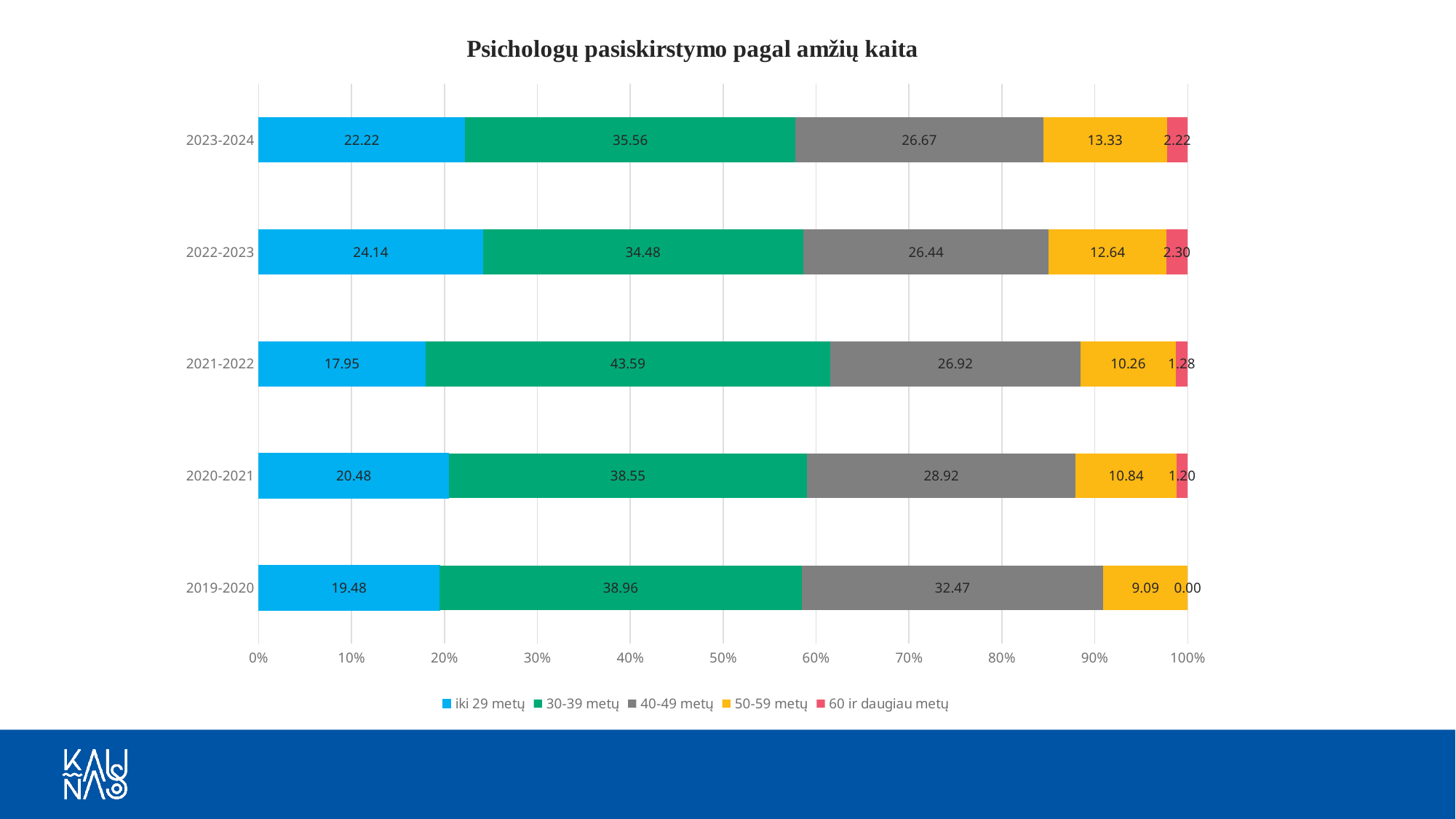
What is the value for the iki 29 metų series in 2022-2023? 24.14 How many series does the legend list? 5 Which period has the highest value for the 40-49 metų series? 2019-2020 Which is larger: the 50-59 metų value in 2020-2021 or in 2021-2022? 2020-2021 What is the value for the 50-59 metų series in 2023-2024? 13.33 What is the value for the 60 ir daugiau metų series in 2019-2020? 0.00 How many periods are shown on the y axis? 5 Which period has the lowest value for the iki 29 metų series? 2021-2022 What kind of chart is shown on the slide? Stacked bar chart What is the difference between the 30-39 metų values for 2021-2022 and 2023-2024? 8.03 What is the title of the chart? Psichologų pasiskirstymo pagal amžių kaita What is the value for the 30-39 metų series in 2021-2022? 43.59